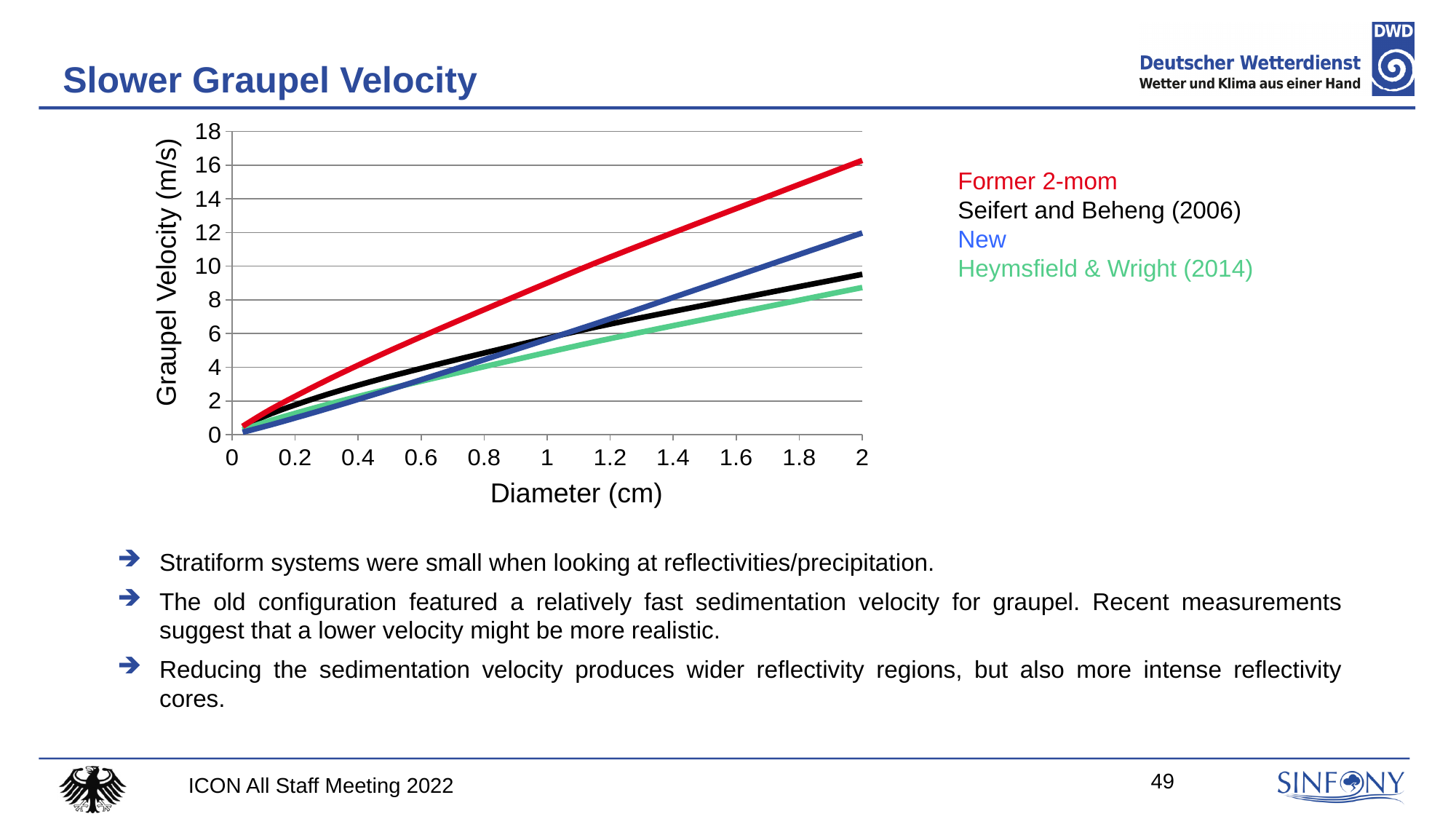
Is the graupel velocity of the New series at a diameter of 2 cm greater or less than 10 m/s? greater Which series has the lowest graupel velocity at a diameter of 2 cm? Heymsfield & Wright (2014) How many series (curves) are listed in the legend of the chart? 4 At a diameter of 0.6 cm, which series has the larger graupel velocity: Seifert and Beheng (2006) or New? Seifert and Beheng (2006) At a diameter of 2 cm, which series has the larger graupel velocity: Former 2-mom or New? Former 2-mom Does the graupel velocity of the Former 2-mom series rise or fall as diameter increases? rise Which series reaches the highest graupel velocity at a diameter of 2 cm? Former 2-mom What kind of chart is shown on the slide? line chart What is the label of the y axis of the chart? Graupel Velocity (m/s) Is the graupel velocity of the Heymsfield & Wright (2014) series at a diameter of 2 cm greater or less than 10 m/s? less What is the label of the x axis of the chart? Diameter (cm) Is the graupel velocity of the Former 2-mom series at a diameter of 2 cm greater or less than 14 m/s? greater